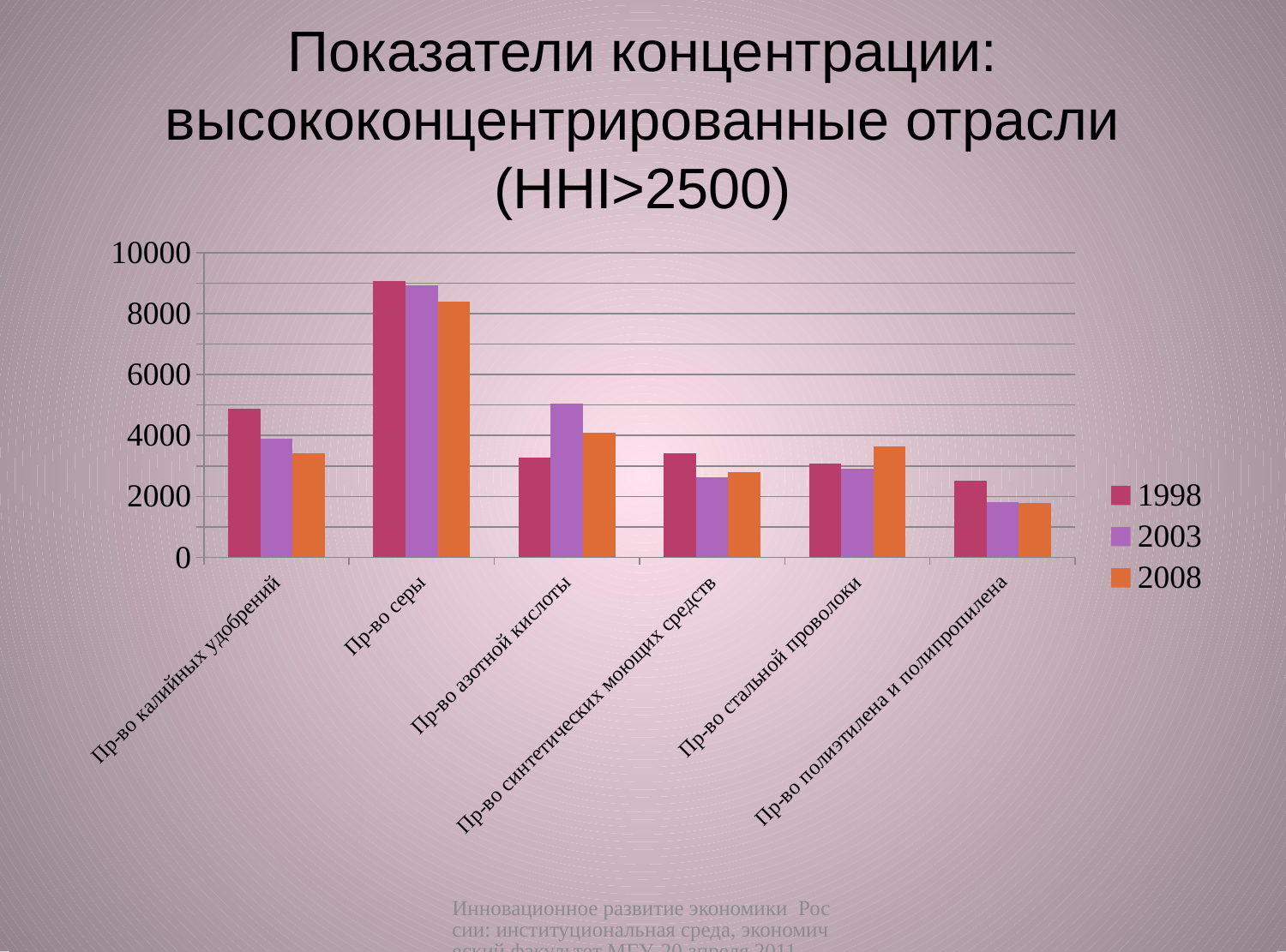
Is the 2008 value for Пр-во полиэтилена и полипропилена greater or less than 2000? less Which series does the legend list? 1998, 2003, 2008 Is the 1998 value for Пр-во калийных удобрений greater or less than 4000? greater Which category has the lowest value for 2008? Пр-во полиэтилена и полипропилена Is the 1998 value for Пр-во серы greater or less than 8000? greater How many series does the legend list? 3 What kind of chart is shown on the slide? bar chart How many industry categories are shown on the x axis? 6 For Пр-во серы, do the values rise or fall from 1998 to 2008? fall Which category has the highest value for 1998? Пр-во серы For Пр-во калийных удобрений, which year has the larger value, 1998 or 2008? 1998